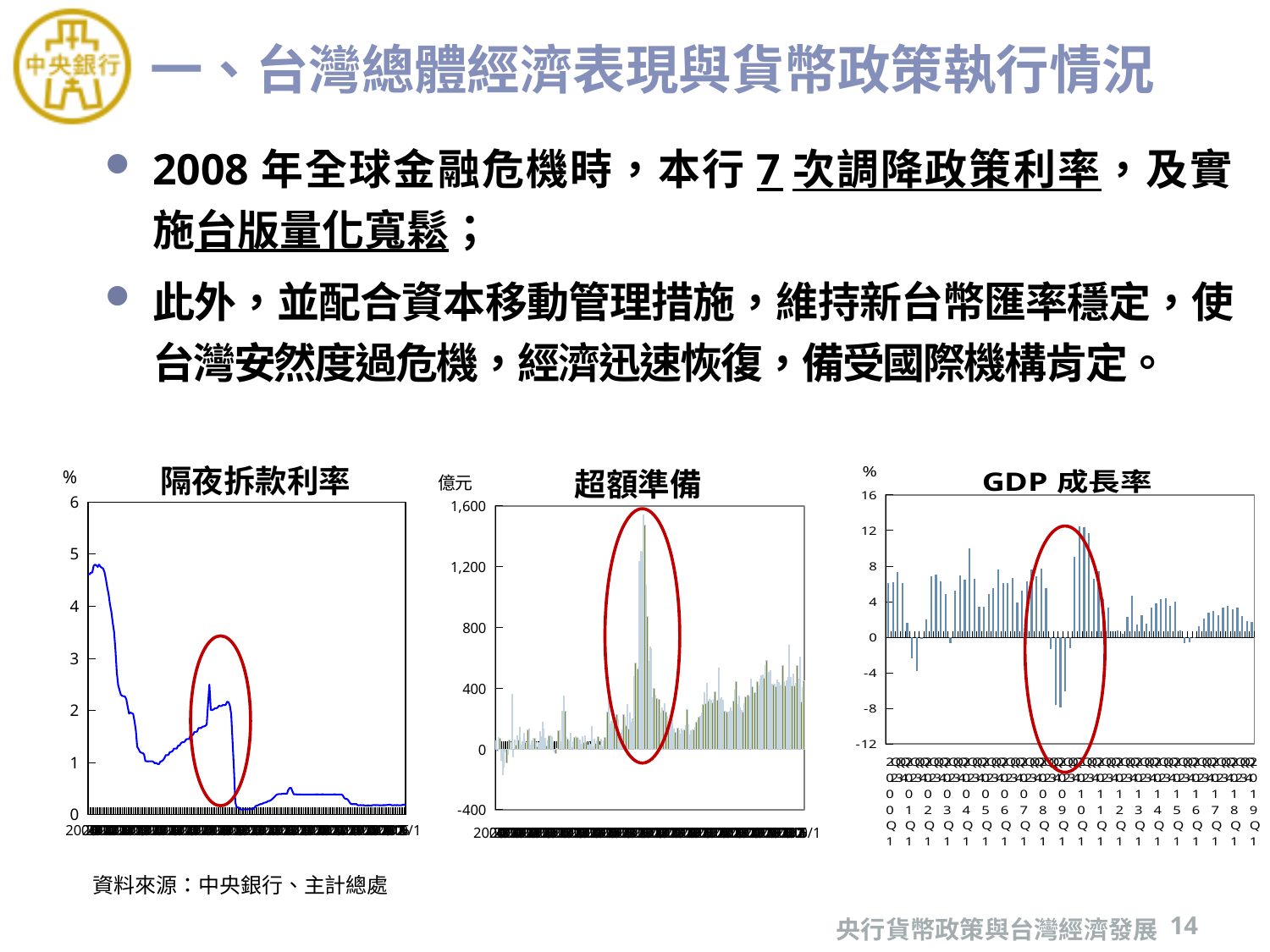
What kind of chart is the 隔夜拆款利率 chart on the left? line chart In the GDP 成長率 chart, is the lowest bar greater or less than -4? less In the 隔夜拆款利率 chart, does the line overall rise or fall from the start to the end of the x axis? fall In the GDP 成長率 chart, is the highest bar greater or less than 8? greater In the 超額準備 chart, what unit is shown on the y axis? 億元 How many charts are shown on the slide? 3 In the 隔夜拆款利率 chart, is the value at the start of the series greater or less than 4? greater What source is given for the charts on the slide? 中央銀行、主計總處 What kind of chart is the 超額準備 chart in the middle? bar chart What kind of chart is the GDP 成長率 chart on the right? bar chart